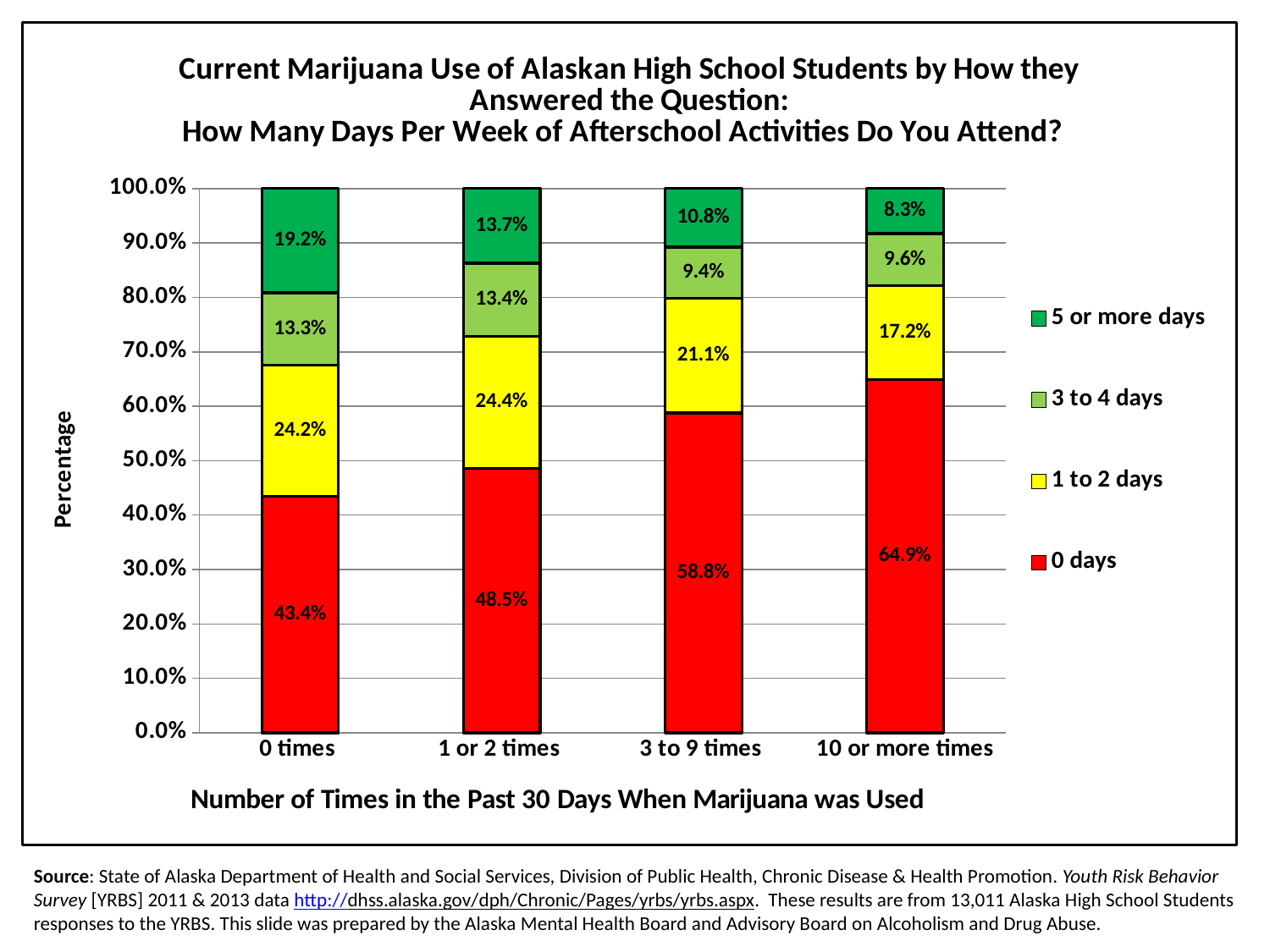
What is the difference in percentage points between the '0 days' value for '10 or more times' and the '0 days' value for '0 times'? 21.5 How many series does the legend list? 4 Which is larger: the '5 or more days' value for '0 times' or the '5 or more days' value for '1 or 2 times'? 0 times What is the value for '3 to 4 days' in the '1 or 2 times' bar? 13.4% What is the value for '5 or more days' in the '10 or more times' bar? 8.3% What kind of chart is shown on the slide? Stacked bar chart Which marijuana-use category has the lowest share of students attending 5 or more days of afterschool activities? 10 or more times Which marijuana-use category has the highest share of students attending 0 days of afterschool activities? 10 or more times How many marijuana-use categories are shown on the x axis? 4 Does the '0 days' share rise or fall as the number of times marijuana was used increases along the x axis? Rises What percentage of students who used marijuana 0 times reported attending 0 days of afterschool activities? 43.4% What is the value for '1 to 2 days' in the '3 to 9 times' bar? 21.1%